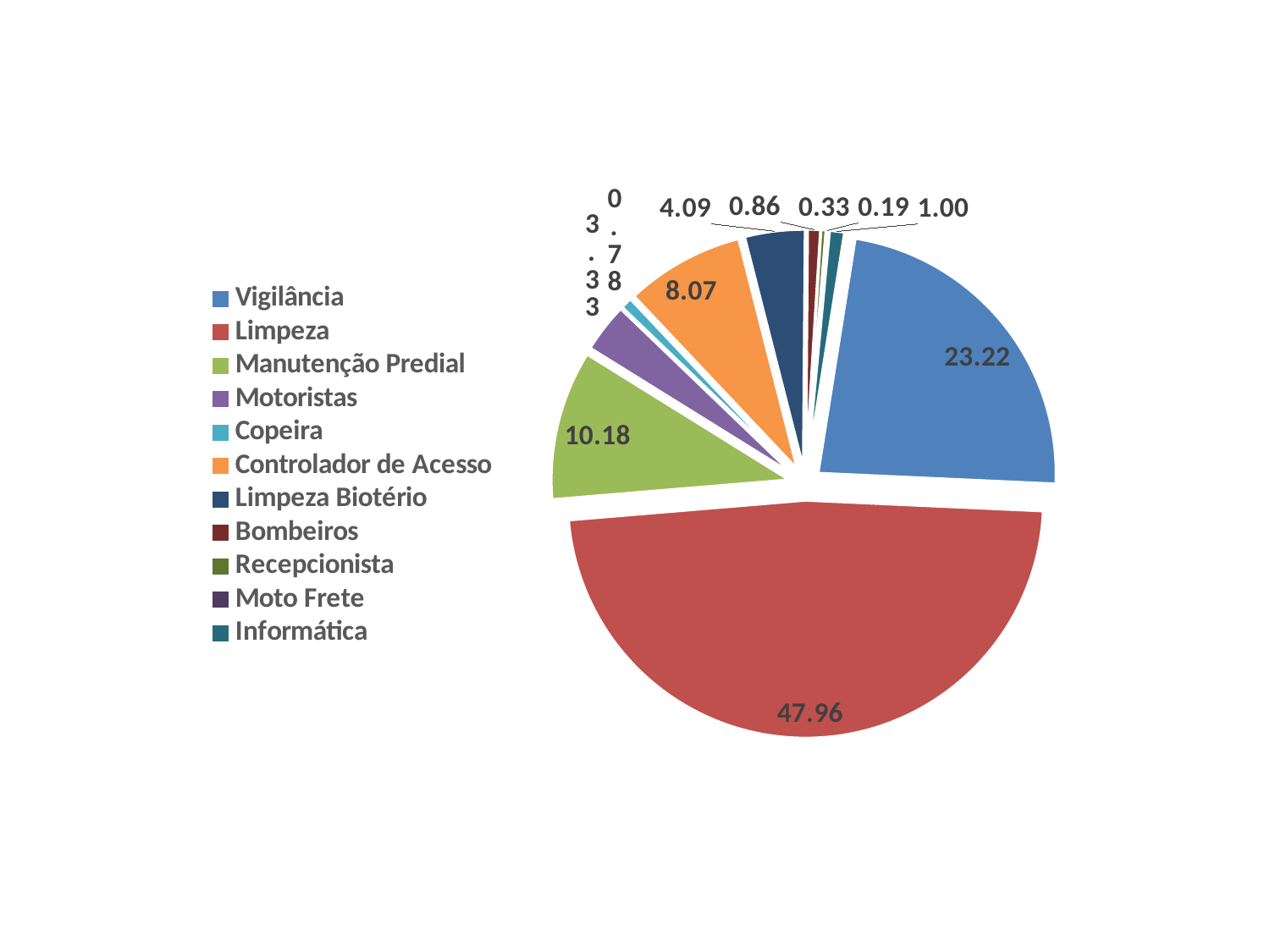
What is the value shown for the Limpeza slice? 47.96 What is the value shown for Informática? 1.00 What is the value shown for Controlador de Acesso? 8.07 How many categories does the pie chart show? 11 What kind of chart is shown on the slide? Pie chart What is the difference between the values for Limpeza and Vigilância? 24.74 What is the value shown for Manutenção Predial? 10.18 What is the value shown for the Vigilância slice? 23.22 Which is larger, the value for Manutenção Predial or the value for Controlador de Acesso? Manutenção Predial What is the value shown for Limpeza Biotério? 4.09 Which category has the largest slice of the pie? Limpeza Which category has the smallest slice of the pie? Moto Frete